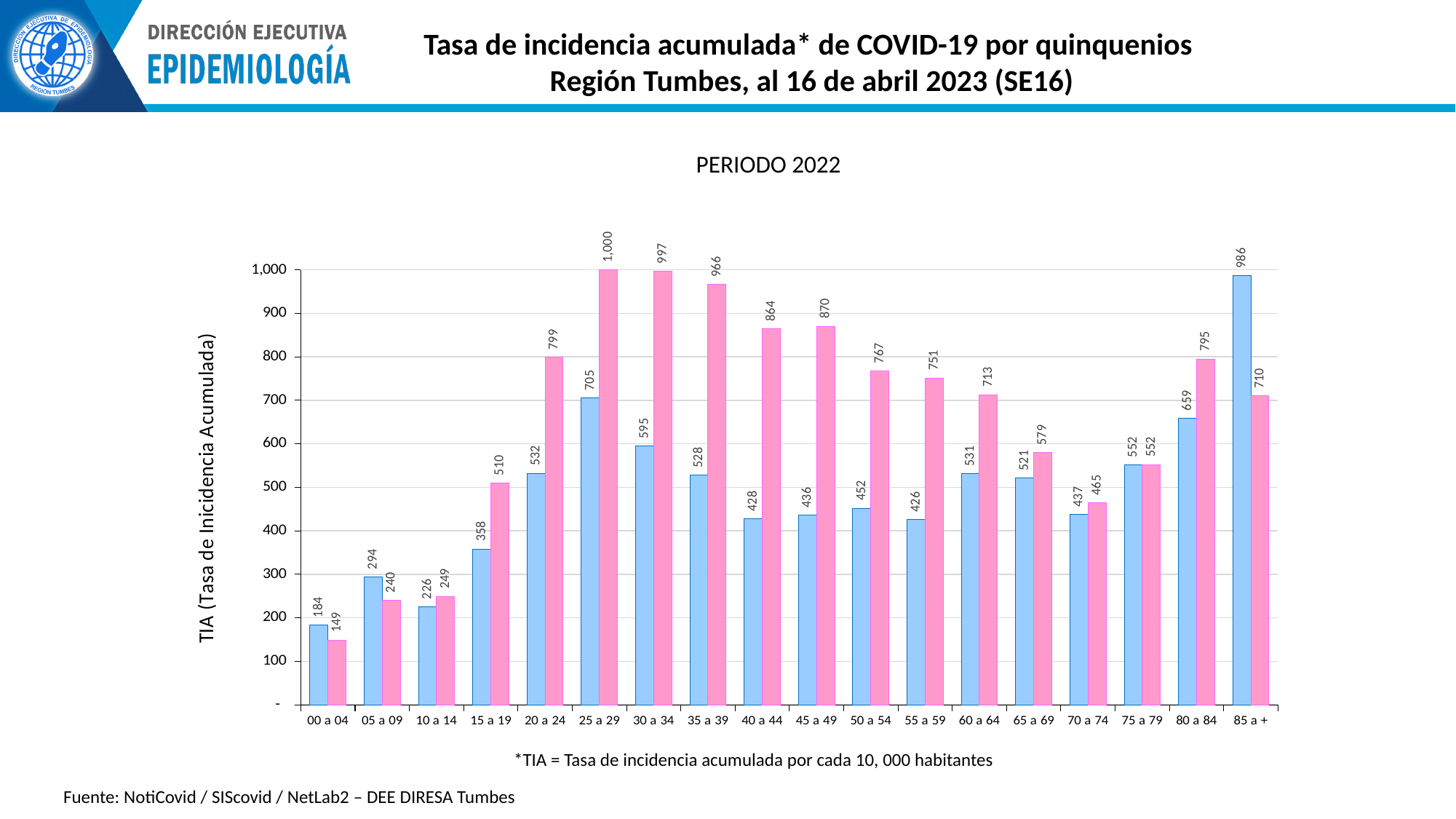
What is the subtitle shown above the chart? PERIODO 2022 What kind of chart is shown on the slide? bar chart Which age group has the lowest pink bar? 00 a 04 What is the value of the blue bar for the 85 a + age group? 986 Which age group has the highest pink bar? 25 a 29 What is the difference between the pink and blue bars for the 20 a 24 age group? 267 Which is larger for the 85 a + age group, the blue bar or the pink bar? the blue bar What is the value of the pink bar for the 40 a 44 age group? 864 Which age group has the highest blue bar? 85 a + Is the value of the pink bar for the 30 a 34 age group greater or less than 900? greater What is the value of the blue bar for the 25 a 29 age group? 705 How many age groups are shown on the x axis? 18